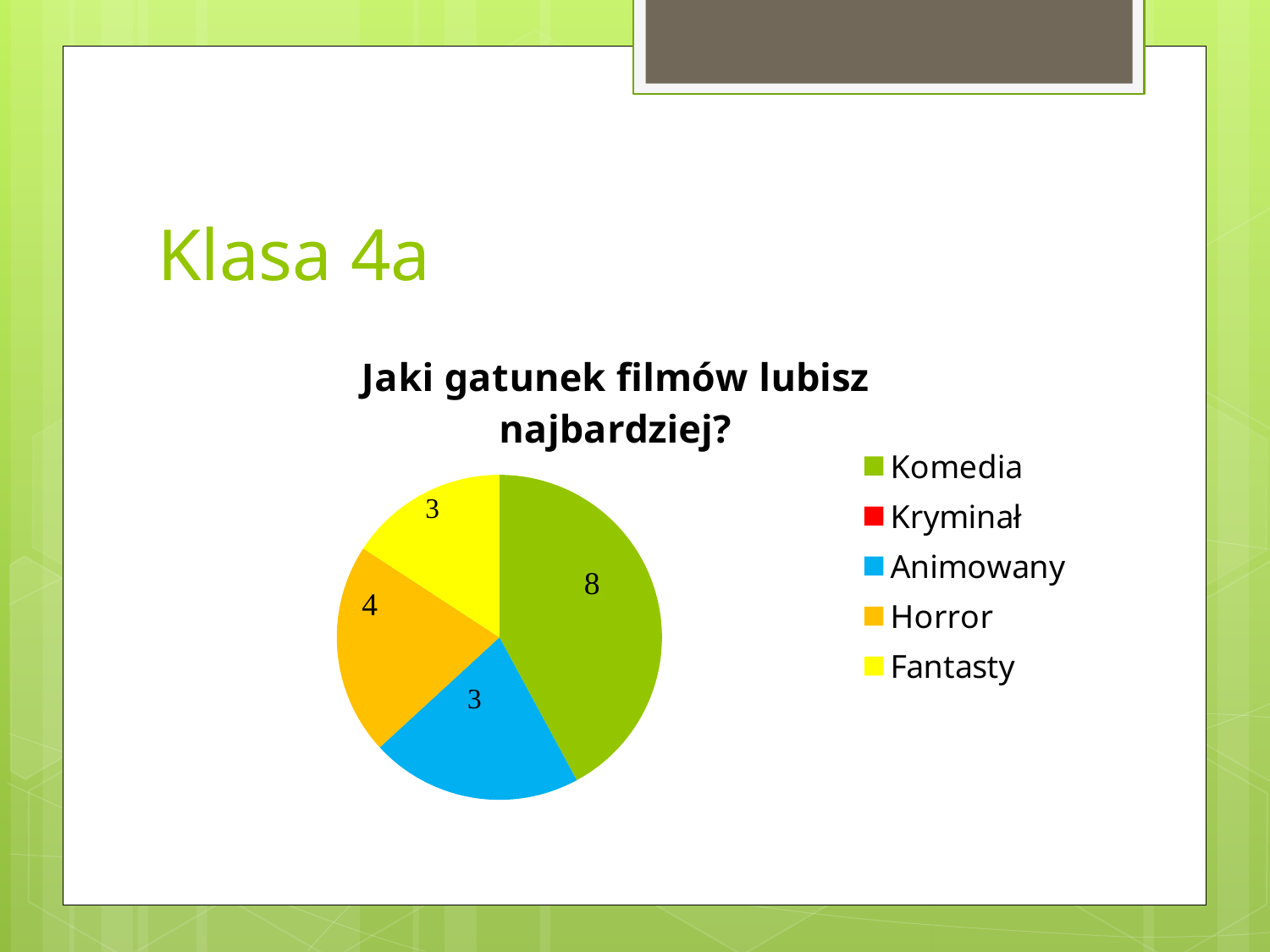
What is the difference between the values for Horror and Animowany? 1 Which category has the largest slice in the pie chart? Komedia Which is larger, the value for Horror or the value for Fantasty? Horror What kind of chart is shown on the slide? Pie chart What is the difference between the values for Komedia and Horror? 4 What value is shown for Komedia in the pie chart? 8 What is the title of the chart? Jaki gatunek filmów lubisz najbardziej? How many categories does the legend of the pie chart list? 5 What value is shown for Fantasty in the pie chart? 3 What value is shown for Animowany in the pie chart? 3 What colour represents Komedia in the pie chart? Green What value is shown for Horror in the pie chart? 4